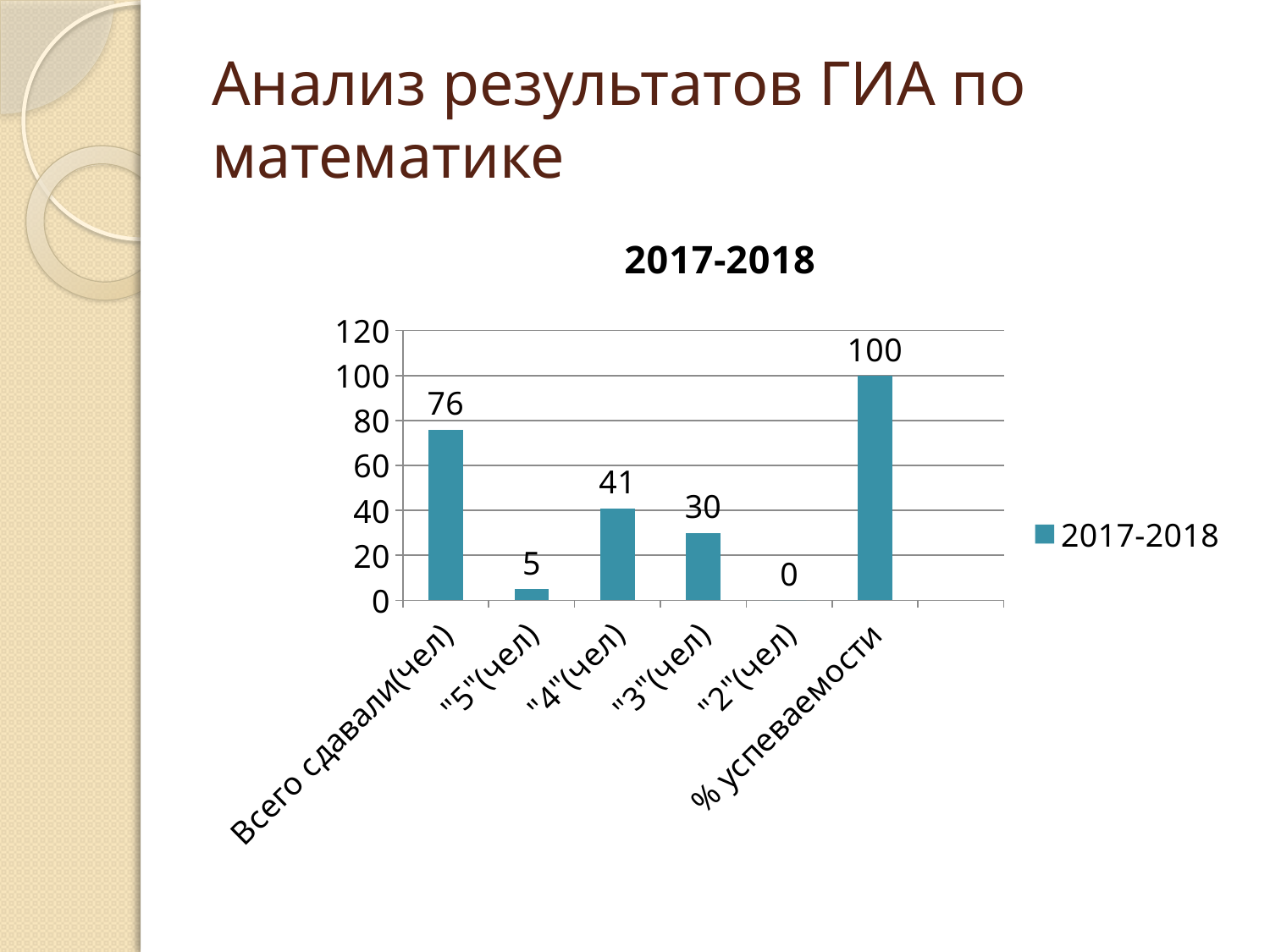
What is the value for "Всего сдавали(чел)"? 76 How many series does the legend list? 1 What kind of chart is shown? bar chart What is the value for "4"(чел)? 41 Which category has the lowest value? "2"(чел) Which is larger, the value for "5"(чел) or the value for "3"(чел)? "3"(чел) Which category has the highest value? % успеваемости How many categories are shown on the x axis? 6 What is the value for "5"(чел)? 5 What is the value for "% успеваемости"? 100 What is the difference between the values for "4"(чел) and "3"(чел)? 11 What is the value for "3"(чел)? 30